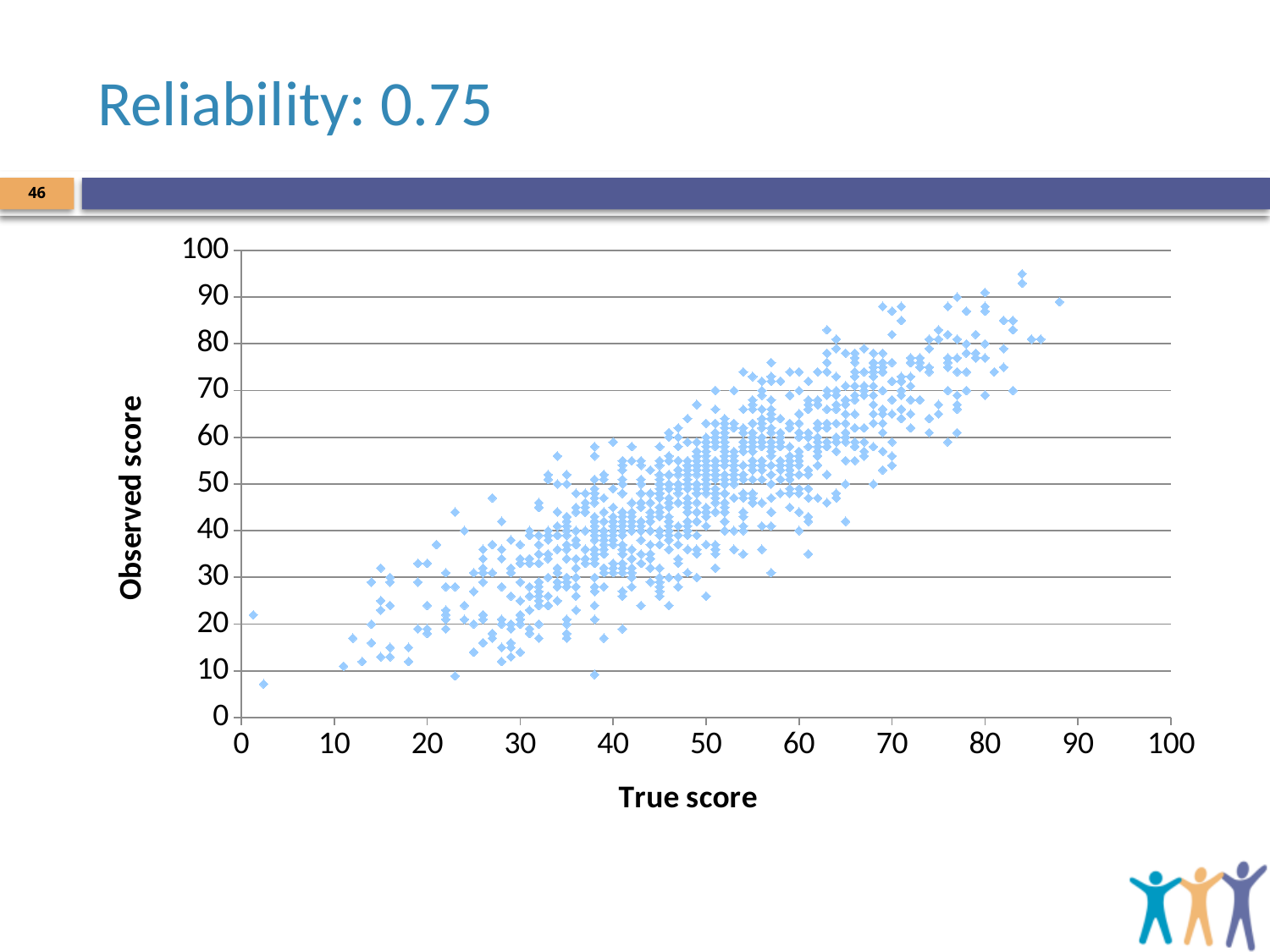
As the true score increases along the x axis, do the observed scores generally rise or fall? rise Is the lowest observed score plotted greater or less than 10? less What is the interval between tick marks on the x axis? 10 What is the label of the y axis? Observed score Is the observed score of the point with the lowest true score greater or less than 30? less What is the maximum value shown on the y axis? 100 Is the highest observed score plotted greater or less than 90? greater What is the label of the x axis? True score What kind of chart is shown on the slide? scatter plot What is the maximum value shown on the x axis? 100